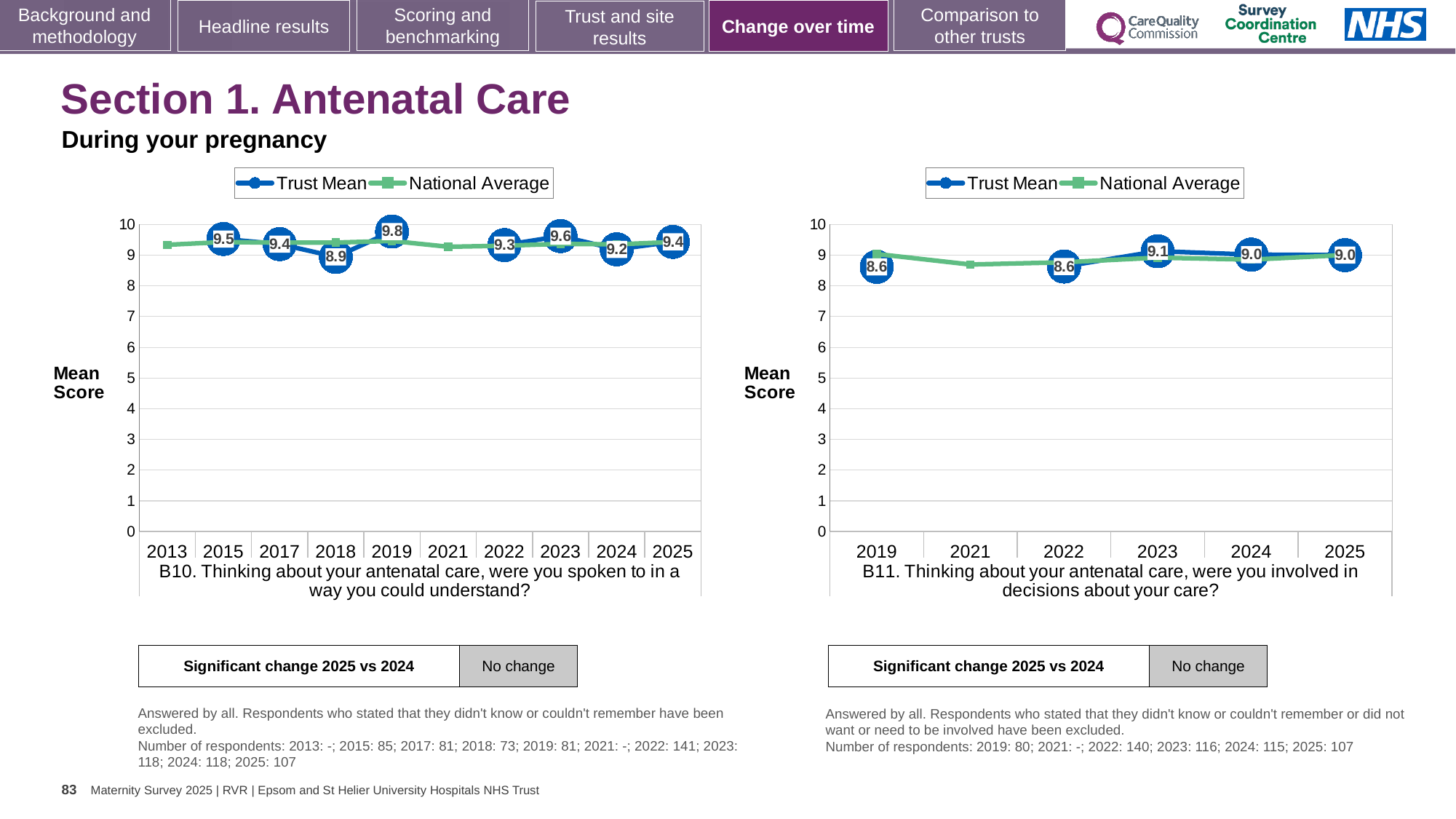
In the B10 chart on the left, what is the Trust Mean for 2019? 9.8 In the B11 chart on the right, is the National Average for 2021 greater or less than 8? greater In the B11 chart on the right, which year has the highest Trust Mean? 2023 In the B11 chart on the right, is the Trust Mean for 2023 larger or smaller than the Trust Mean for 2022? larger In the B10 chart on the left, what is the difference between the Trust Mean for 2019 and the Trust Mean for 2018? 0.9 In the B11 chart on the right, what is the Trust Mean for 2023? 9.1 In the B10 chart on the left, which year has the lowest Trust Mean? 2018 In the B10 chart on the left, which year has the highest Trust Mean? 2019 In the B11 chart on the right, how many series does the legend list? 2 What kind of chart is the B11 chart on the right? line chart In the B10 chart on the left, how many years are shown on the x axis? 10 In the B10 chart on the left, what is the Trust Mean for 2018? 8.9